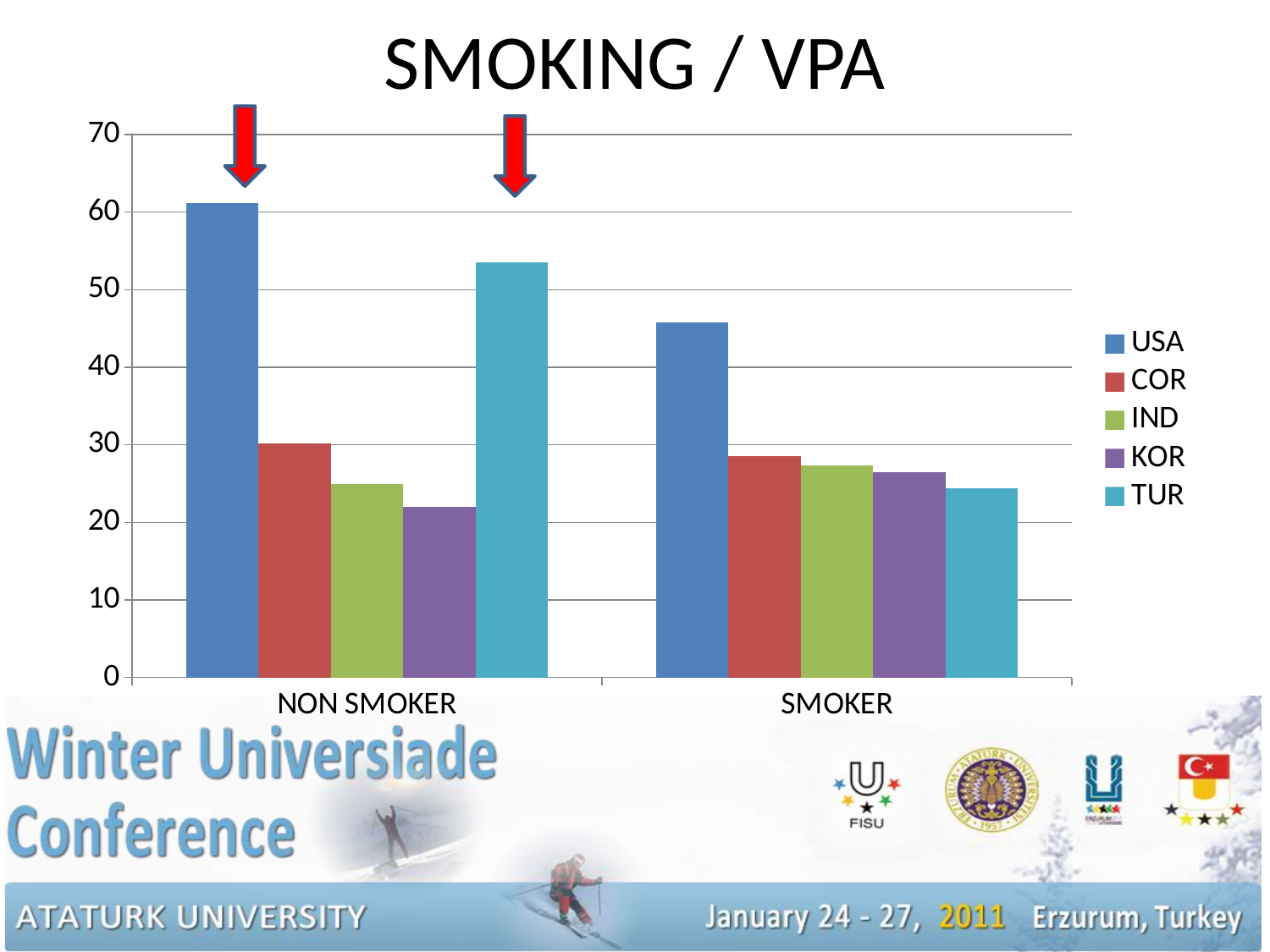
How many series does the legend list? 5 Is the value for TUR in the NON SMOKER group greater or less than 50? greater Is the value for USA in the SMOKER group greater or less than 40? greater How many categories are shown on the x axis? 2 Which is larger: the TUR value for NON SMOKER or the TUR value for SMOKER? NON SMOKER Which series has the highest value in the SMOKER group? USA Which series has the highest value in the NON SMOKER group? USA Is the value for TUR in the SMOKER group greater or less than 30? less What is the title of the chart? SMOKING / VPA Which series has the lowest value in the NON SMOKER group? KOR What kind of chart is shown on the slide? bar chart